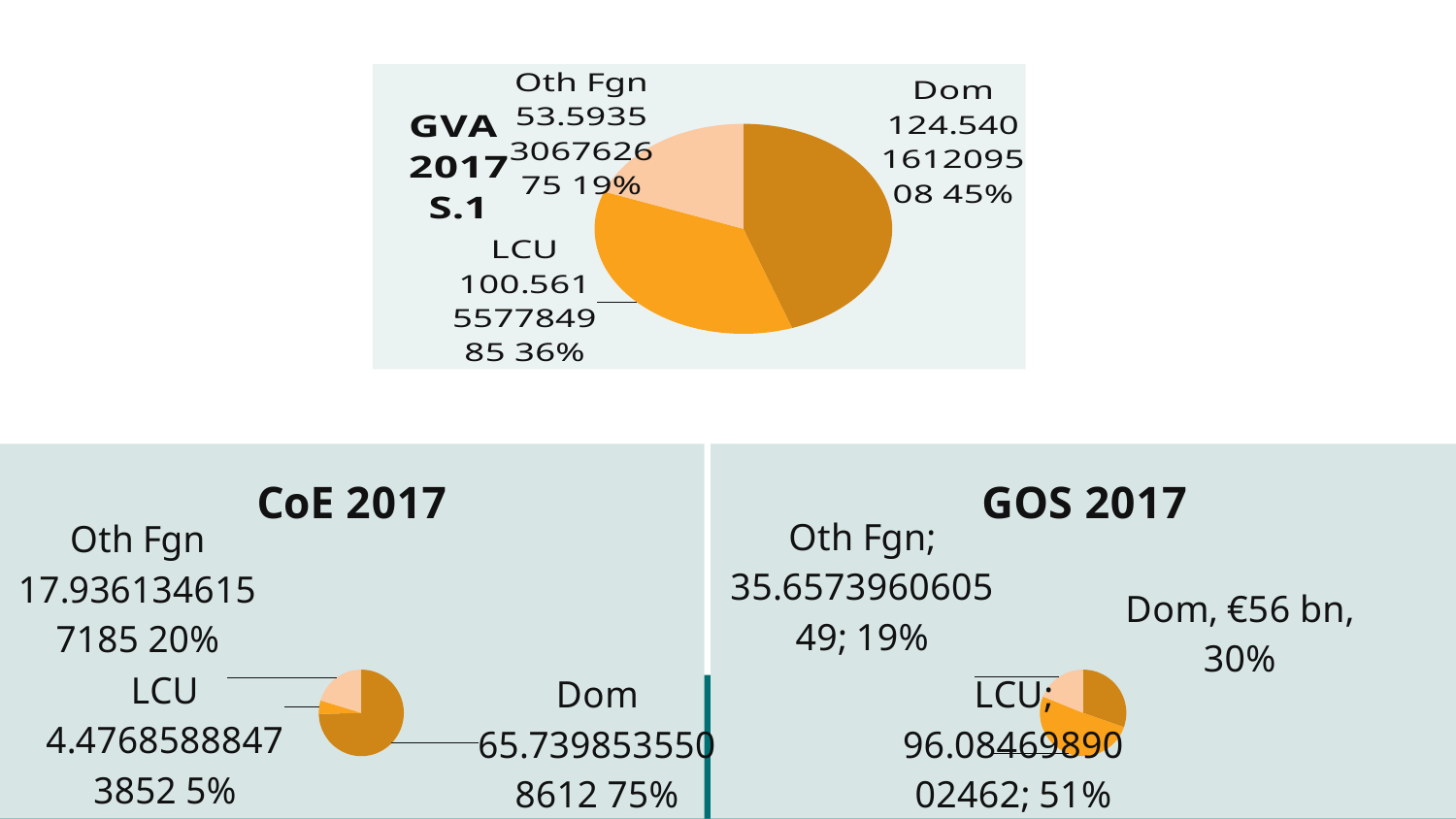
In the CoE 2017 chart, which slice is the largest? Dom What is the title of the pie chart at the bottom right of the slide? GOS 2017 In the GVA 2017 S.1 chart, what share does Dom have? 45% In the GVA 2017 S.1 chart, what share does LCU have? 36% In the CoE 2017 chart, what share does Dom have? 75% In the GVA 2017 S.1 chart, which slice is the smallest? Oth Fgn How many slices does the CoE 2017 pie chart have? 3 In the GOS 2017 chart, what value is shown for Dom? €56 bn What type of chart is the GVA 2017 S.1 chart? pie chart In the GOS 2017 chart, which is larger, Dom or Oth Fgn? Dom